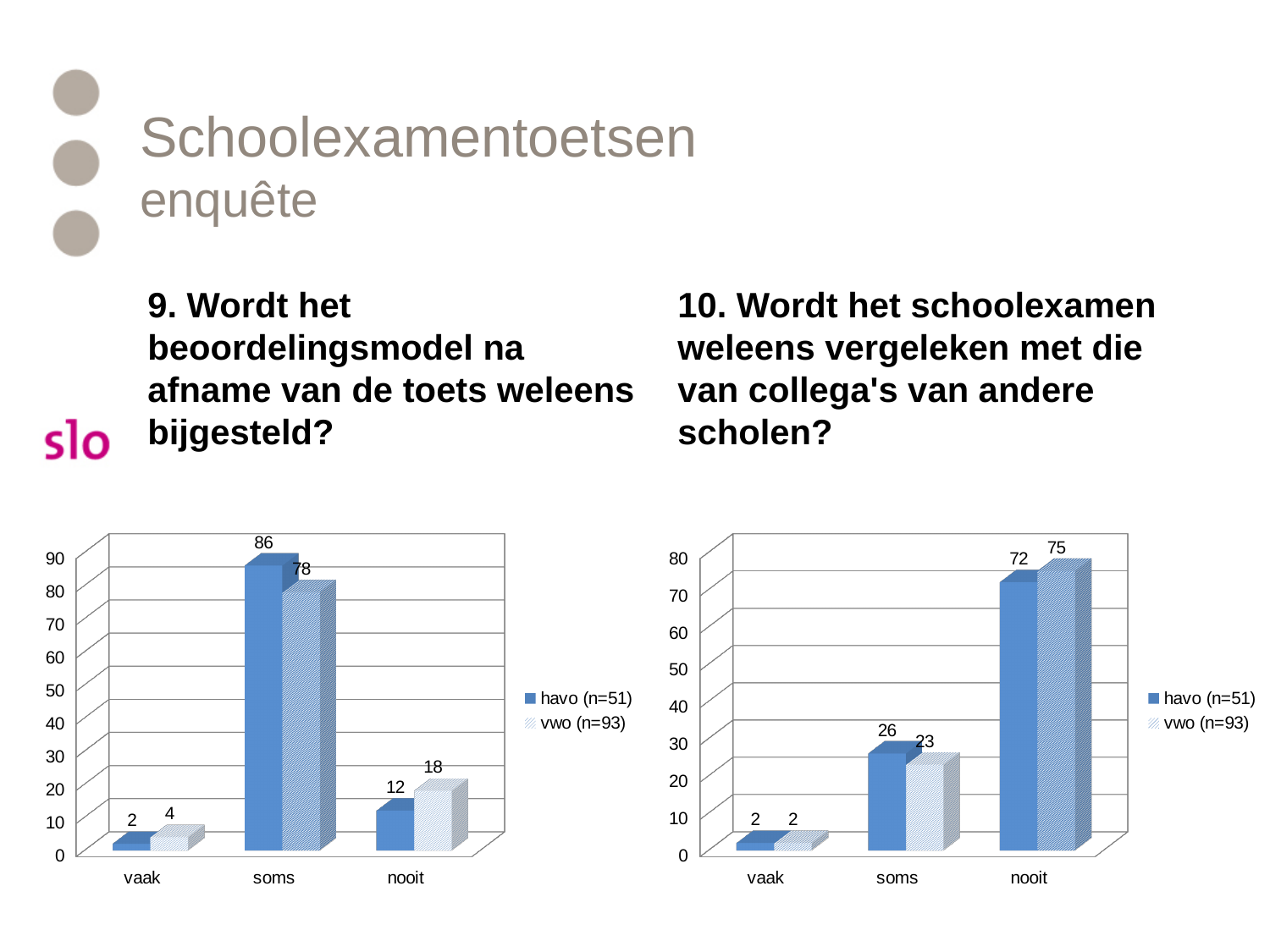
In the right chart (question 10), what is the value for havo (n=51) for 'soms'? 26 In the left chart (question 9), what is the difference between the havo (n=51) and vwo (n=93) values for 'soms'? 8 In the left chart (question 9), which is larger for 'nooit': havo (n=51) or vwo (n=93)? vwo (n=93) How many series does the legend of the left chart (question 9) list? 2 In the right chart (question 10), what is the difference between the vwo (n=93) and havo (n=51) values for 'nooit'? 3 In the left chart (question 9), which category has the highest value for havo (n=51)? soms In the left chart (question 9), what is the value for havo (n=51) for 'soms'? 86 In the left chart (question 9), what is the value for vwo (n=93) for 'nooit'? 18 What kind of chart is the right chart (question 10)? bar chart In the right chart (question 10), which category has the lowest value for vwo (n=93)? vaak In the right chart (question 10), what is the value for vwo (n=93) for 'nooit'? 75 How many categories are shown on the x axis of the right chart (question 10)? 3